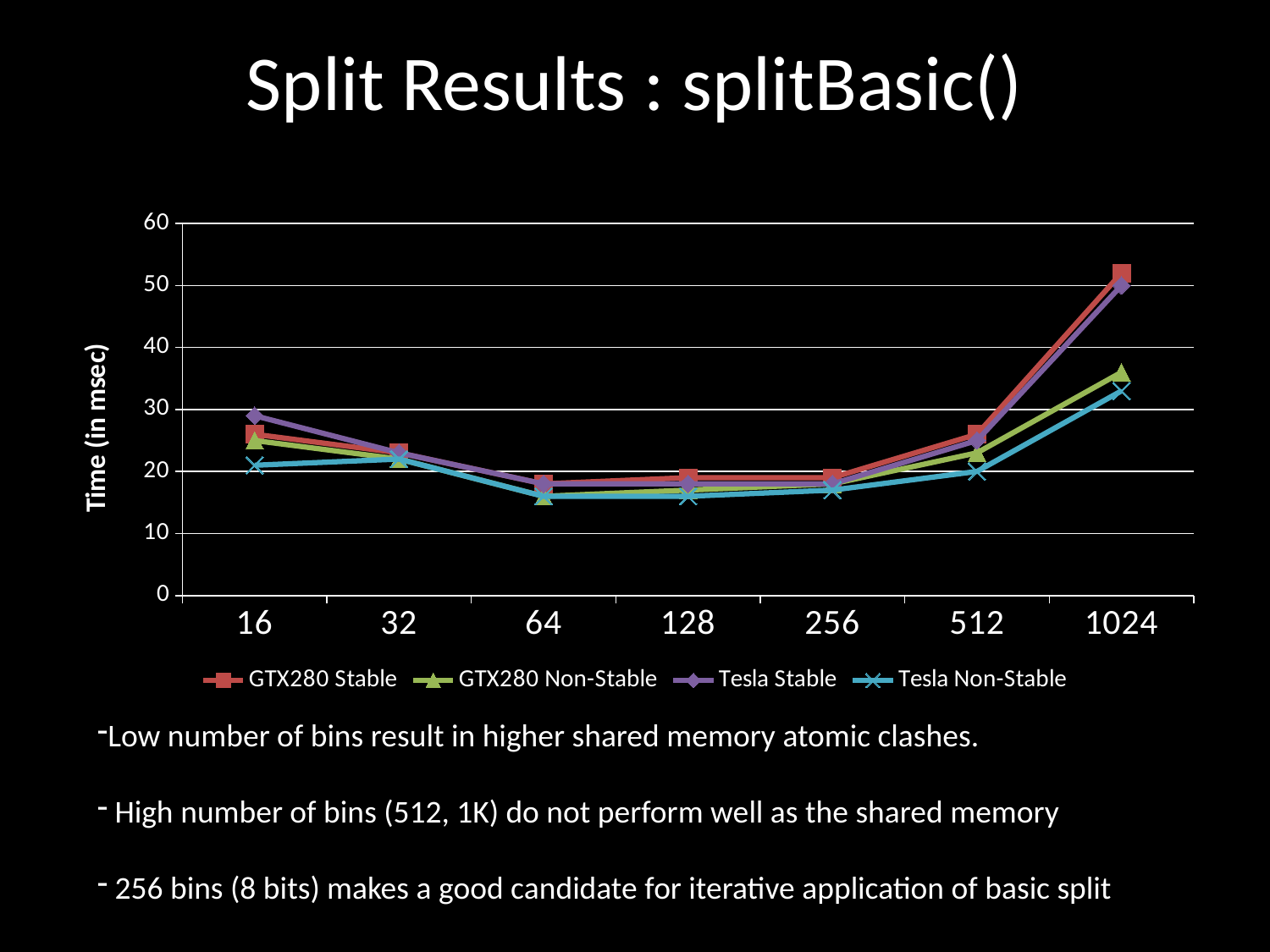
How many series does the legend list? 4 What kind of chart is shown on the slide? line chart What is the label of the vertical axis? Time (in msec) Is the value for GTX280 Stable at 1024 greater or less than 50? greater Which series has the lowest value at 16? Tesla Non-Stable How many categories are shown along the x axis? 7 Which series has the highest value at 16? Tesla Stable Is the value for GTX280 Non-Stable at 1024 greater or less than 30? greater Which series is represented by the blue line with x markers? Tesla Non-Stable At 1024, which is larger: GTX280 Stable or GTX280 Non-Stable? GTX280 Stable Is the value for GTX280 Non-Stable at 64 greater or less than 20? less